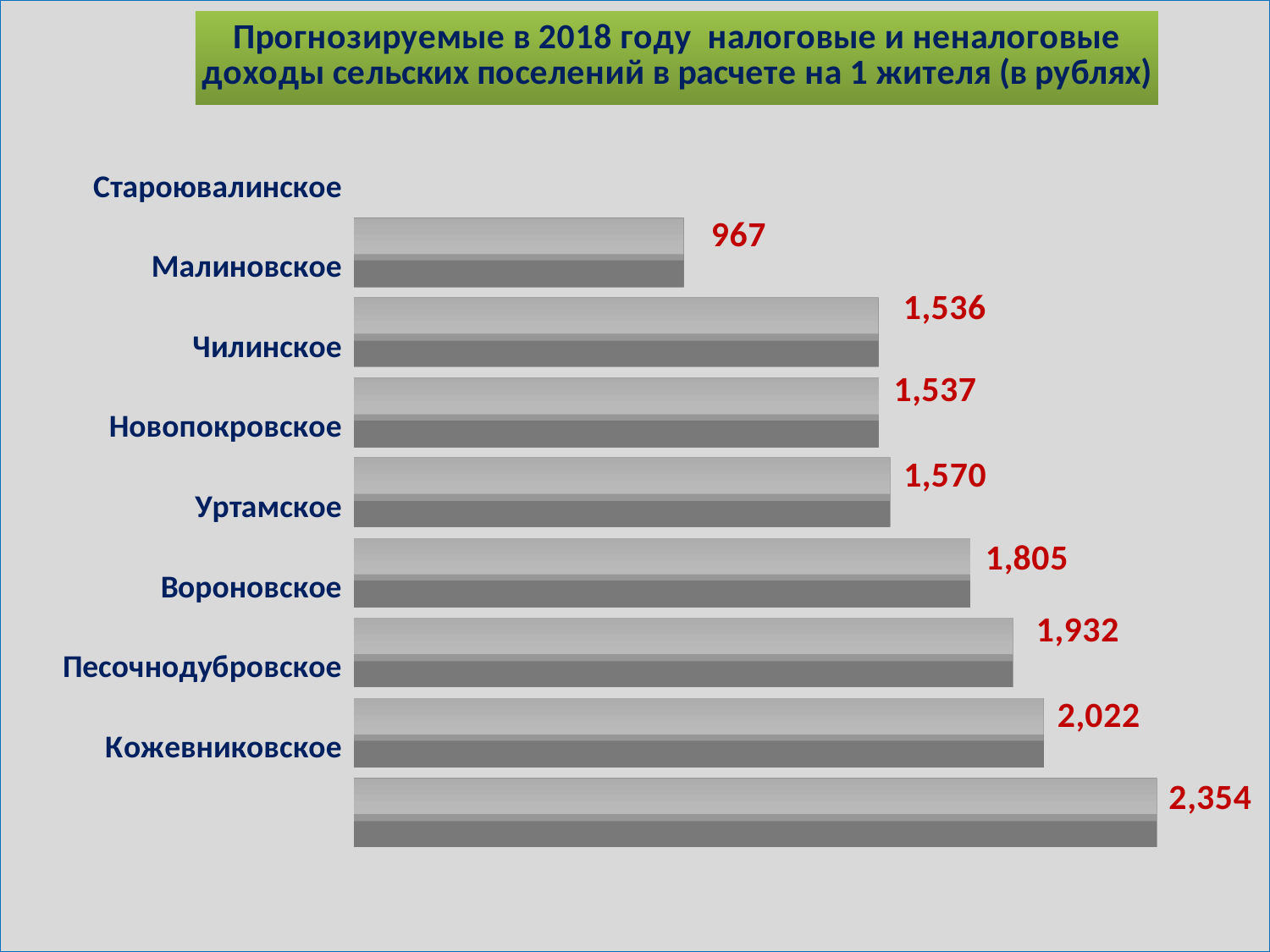
Which is larger, the value for Вороновское or the value for Малиновское? Вороновское What is the value shown for Песочнодубровское? 2,022 How many rural settlements (bars) are shown in the chart? 8 What is the value shown for Уртамское? 1,805 For which year are the incomes in the chart forecast, according to the title? 2018 What is the value shown for Кожевниковское? 2,354 What is the value shown for Староювалинское? 967 Which settlement has the highest forecast income per resident? Кожевниковское Which settlement has the lowest forecast income per resident? Староювалинское What is the difference between the values for Кожевниковское and Староювалинское? 1,387 What kind of chart is shown on the slide? bar chart Do the values increase or decrease going from the top bar to the bottom bar? increase